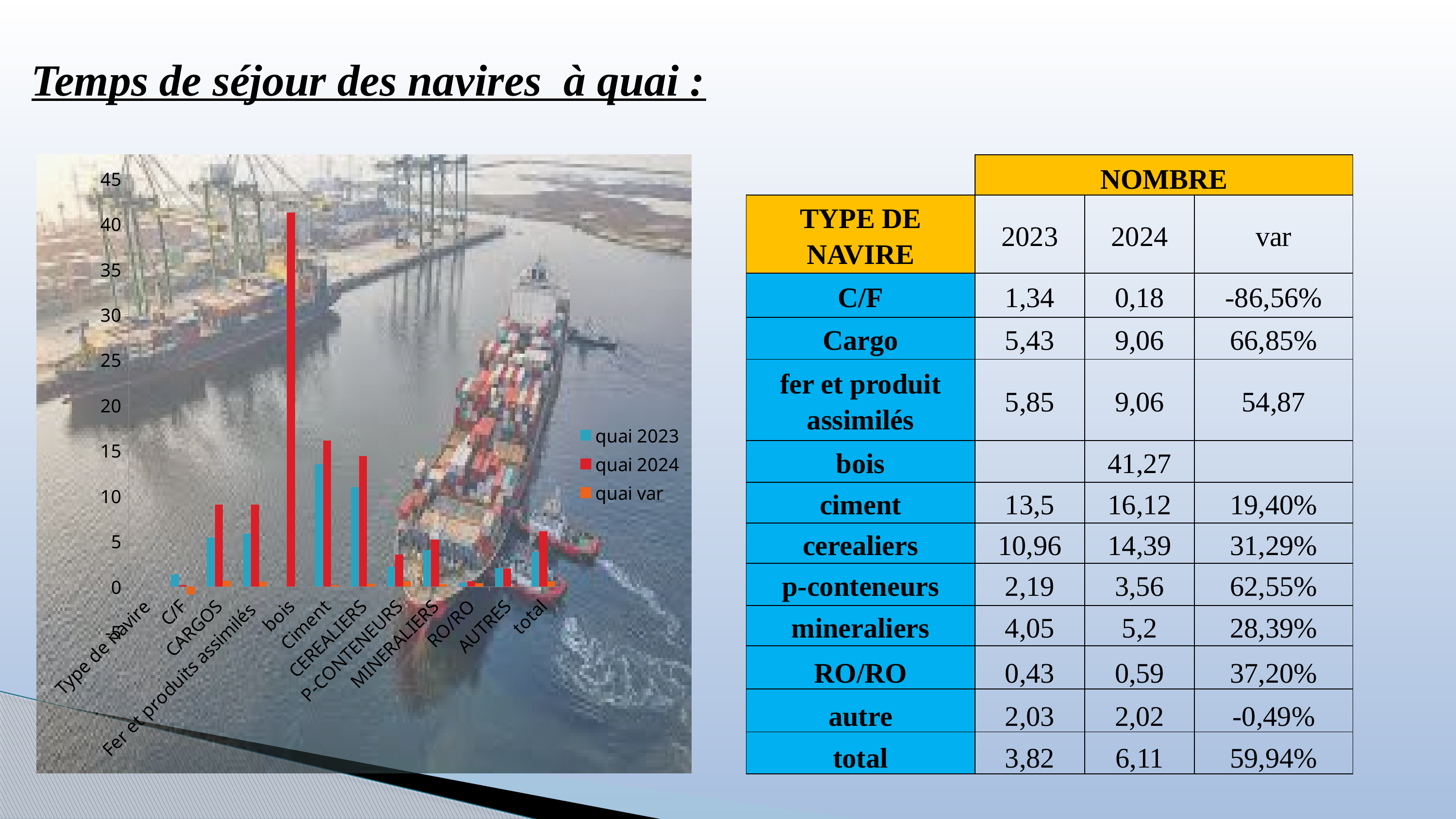
Is the quai 2024 value for CARGOS greater or less than 10? less Which category has the highest quai 2023 bar in the chart? Ciment What is the name of the third series listed in the chart legend? quai var Is the quai 2024 value for bois greater or less than 35? greater Is the quai 2023 value for Ciment greater or less than 10? greater What kind of chart is shown on the left of the slide? bar chart In the chart, which is larger for Ciment: the quai 2023 bar or the quai 2024 bar? quai 2024 Which category has the highest quai 2024 bar in the chart? bois In the chart, which quai 2024 bar is taller: Ciment or CEREALIERS? Ciment What colour are the quai 2024 bars in the chart? red How many series does the chart legend list? 3